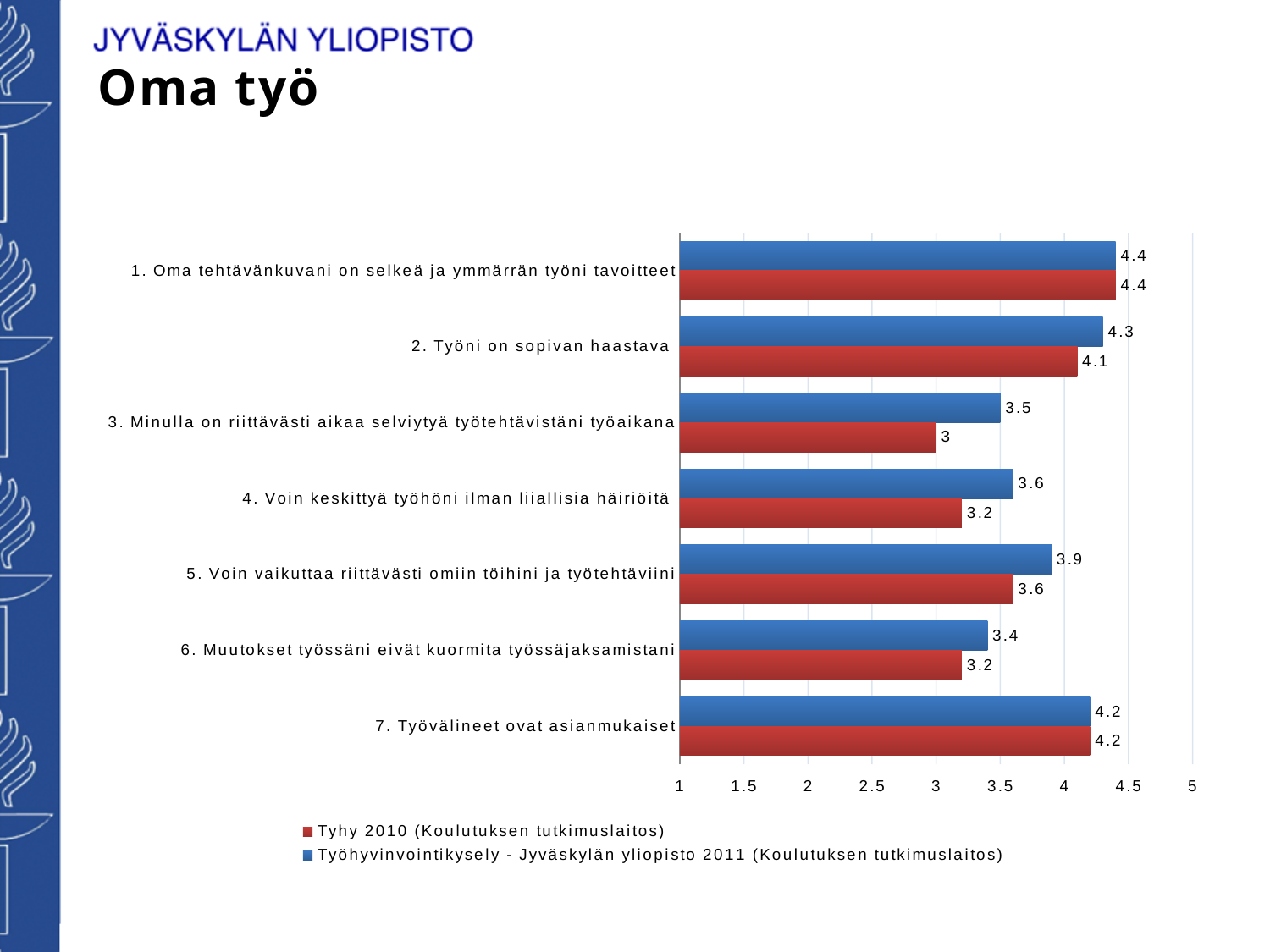
Is the Tyhy 2010 value for '6. Muutokset työssäni eivät kuormita työssäjaksamistani' greater or less than 3.5? less Which statement has the highest value in the Työhyvinvointikysely - Jyväskylän yliopisto 2011 series? 1. Oma tehtävänkuvani on selkeä ja ymmärrän työni tavoitteet What is the difference between the 2011 and 2010 values for '3. Minulla on riittävästi aikaa selviytyä työtehtävistäni työaikana'? 0.5 What is the value for '2. Työni on sopivan haastava' in the Tyhy 2010 series? 4.1 Which statement has the lowest value in the Tyhy 2010 series? 3. Minulla on riittävästi aikaa selviytyä työtehtävistäni työaikana For '4. Voin keskittyä työhöni ilman liiallisia häiriöitä', which series has the larger value, Tyhy 2010 or Työhyvinvointikysely 2011? Työhyvinvointikysely - Jyväskylän yliopisto 2011 What kind of chart is shown on the slide? Bar chart How many series does the legend list? 2 Which colour represents the Tyhy 2010 series? Red What is the value for '5. Voin vaikuttaa riittävästi omiin töihini ja työtehtäviini' in the Tyhy 2010 series? 3.6 How many categories (statements) are shown on the chart? 7 What is the value for '3. Minulla on riittävästi aikaa selviytyä työtehtävistäni työaikana' in the Työhyvinvointikysely - Jyväskylän yliopisto 2011 series? 3.5